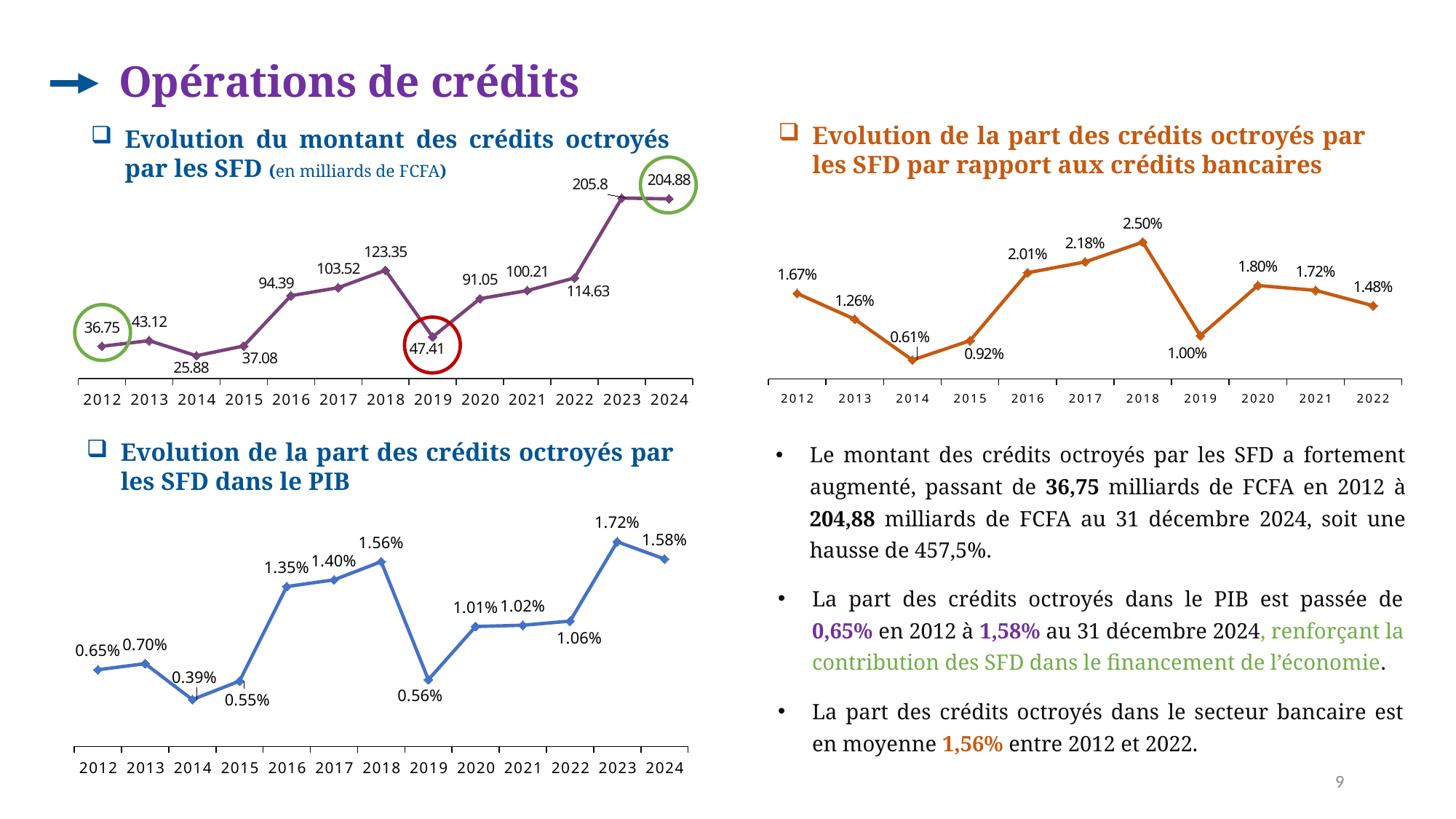
In the chart 'Evolution du montant des crédits octroyés par les SFD', which year has the highest value? 2023 In the chart 'Evolution du montant des crédits octroyés par les SFD', which year has the lowest value? 2014 In the chart 'Evolution de la part des crédits octroyés par les SFD dans le PIB', which year has the highest value? 2023 In the chart 'Evolution de la part des crédits octroyés par les SFD dans le PIB', what is the value for 2014? 0.39% In the chart 'Evolution du montant des crédits octroyés par les SFD', what is the difference between the 2024 value and the 2012 value? 168.13 How many years are plotted in the chart 'Evolution du montant des crédits octroyés par les SFD'? 13 What type of chart is 'Evolution de la part des crédits octroyés par les SFD dans le PIB'? Line chart In the chart 'Evolution de la part des crédits octroyés par les SFD par rapport aux crédits bancaires', which year has the lowest value? 2014 In the chart 'Evolution de la part des crédits octroyés par les SFD par rapport aux crédits bancaires', what is the value for 2018? 2.50% In the chart 'Evolution de la part des crédits octroyés par les SFD par rapport aux crédits bancaires', is the value for 2020 larger or smaller than the value for 2021? larger In the chart 'Evolution du montant des crédits octroyés par les SFD', what is the value for 2019? 47.41 How many years are plotted in the chart 'Evolution de la part des crédits octroyés par les SFD par rapport aux crédits bancaires'? 11